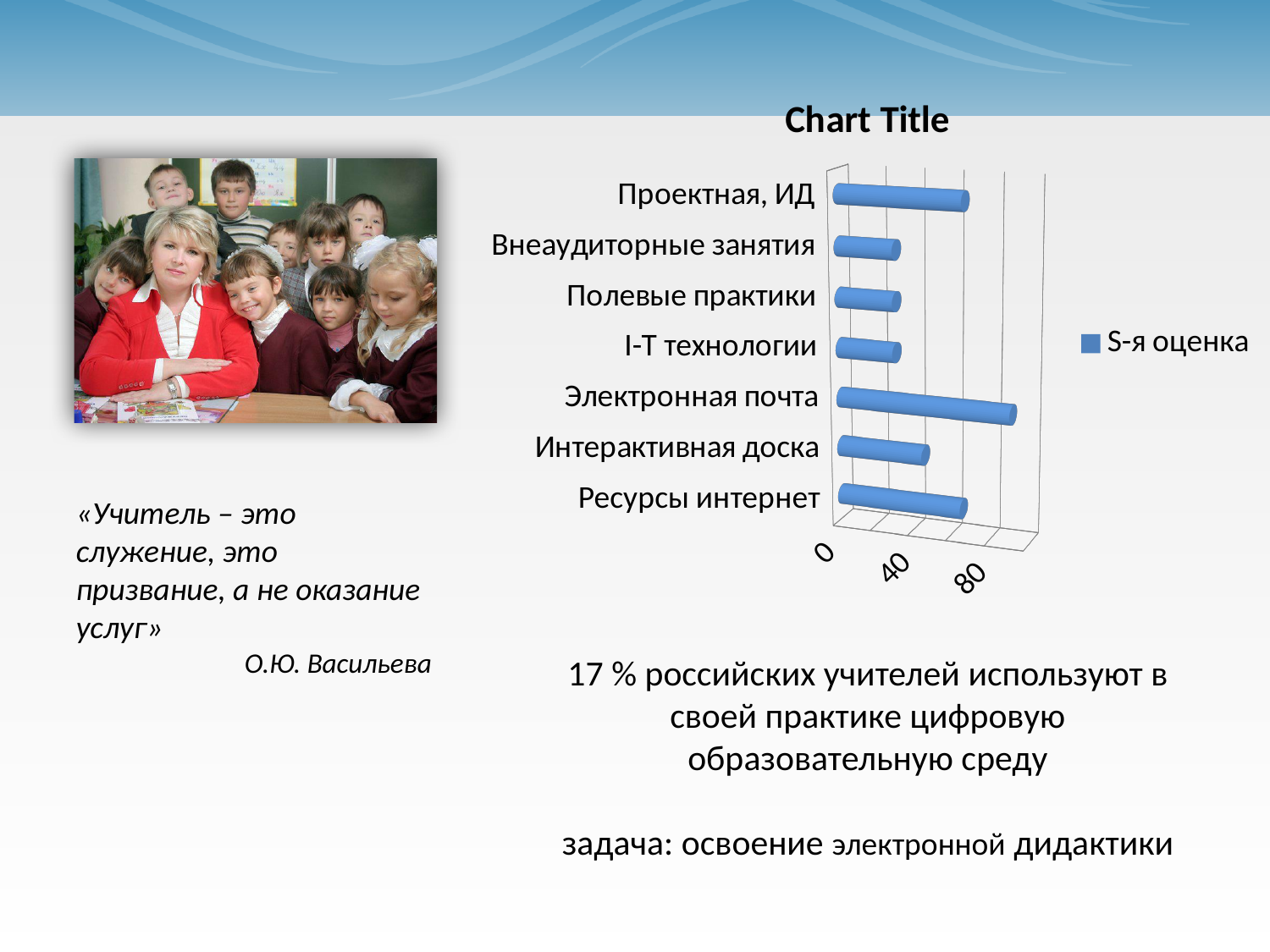
Is the value for Полевые практики greater or less than 80? less How many categories are plotted in the chart? 7 What kind of chart is shown on the slide? bar chart What is the title of the chart? Chart Title What series name is shown in the chart legend? S-я оценка Which has the larger value: Ресурсы интернет or Полевые практики? Ресурсы интернет Is the value for Проектная, ИД greater or less than 40? greater Which has the larger value: Электронная почта or Интерактивная доска? Электронная почта Is the value for Ресурсы интернет greater or less than 80? less Which has the larger value: Проектная, ИД or Внеаудиторные занятия? Проектная, ИД Which category has the highest value in the chart? Электронная почта How many series does the chart legend list? 1